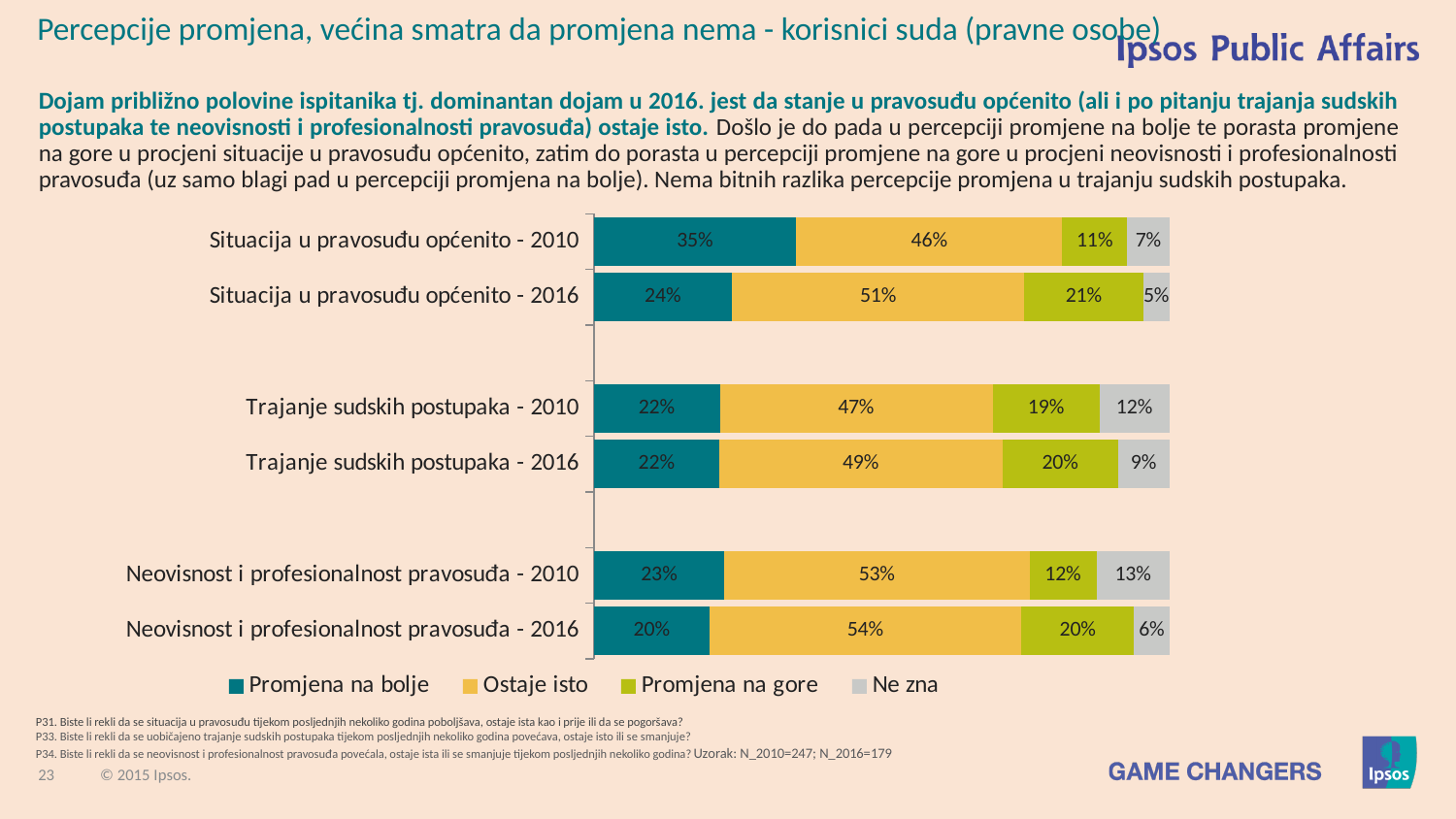
Which category has the lowest value for "Ne zna"? Situacija u pravosuđu općenito - 2016 What type of chart is shown on the slide? Stacked bar chart Which legend entry is shown in grey? Ne zna Which category has the highest value for "Promjena na bolje"? Situacija u pravosuđu općenito - 2010 What is the value of "Ne zna" for "Trajanje sudskih postupaka - 2010"? 12% What is the value of "Ostaje isto" for "Neovisnost i profesionalnost pravosuđa - 2016"? 54% What is the total of the stacked bar for "Neovisnost i profesionalnost pravosuđa - 2010"? 101% What is the value of "Promjena na bolje" for "Situacija u pravosuđu općenito - 2010"? 35% How many series does the legend list? 4 What is the difference in "Promjena na gore" between "Situacija u pravosuđu općenito - 2016" and "Situacija u pravosuđu općenito - 2010"? 10 percentage points How many categories (bars) are plotted in the chart? 6 Which is larger: "Ostaje isto" for "Trajanje sudskih postupaka - 2016" or for "Trajanje sudskih postupaka - 2010"? Trajanje sudskih postupaka - 2016